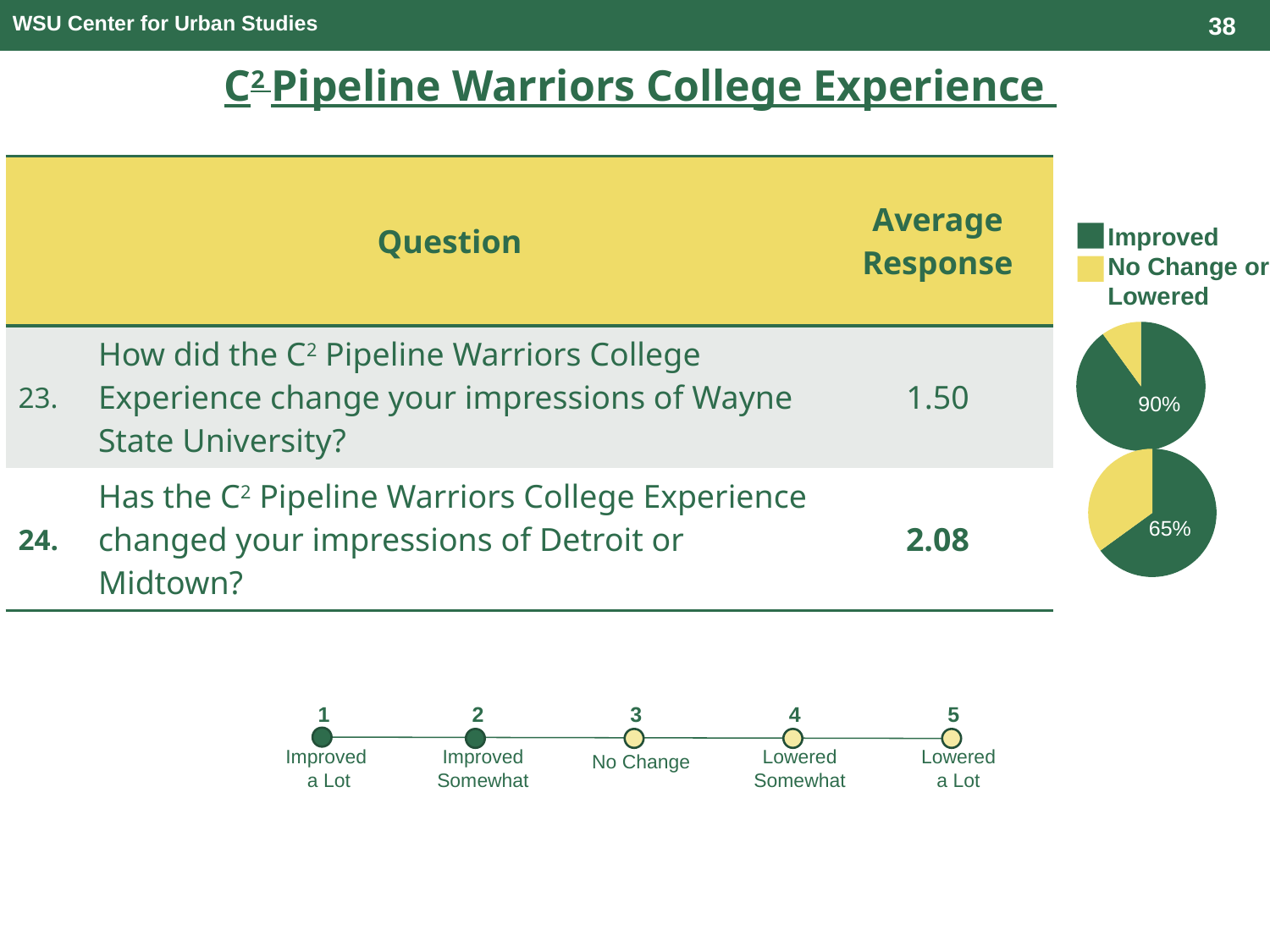
What colour represents 'Improved' in the pie charts? green In the top pie chart (question 23), which category has the largest slice? Improved Which pie chart shows a larger 'Improved' share, the top one (question 23) or the bottom one (question 24)? the top one (question 23) How many percentage points larger is the 'Improved' share in the top pie chart (90%) than in the bottom pie chart (65%)? 25 percentage points What kind of chart is used next to question 23 to show the responses? pie chart How many pie charts are shown on the slide? 2 In the bottom pie chart (question 24), which category has the smallest slice? No Change or Lowered How many categories does the legend for the pie charts list? 2 In the bottom pie chart (question 24), what share of respondents said their impressions of Detroit or Midtown improved? 65% What share of the bottom pie chart (question 24) is taken up by the 'Improved' slice? 65% What legend label corresponds to the yellow slices in the pie charts? No Change or Lowered In the top pie chart (question 23), what share of respondents said their impressions of Wayne State University improved? 90%